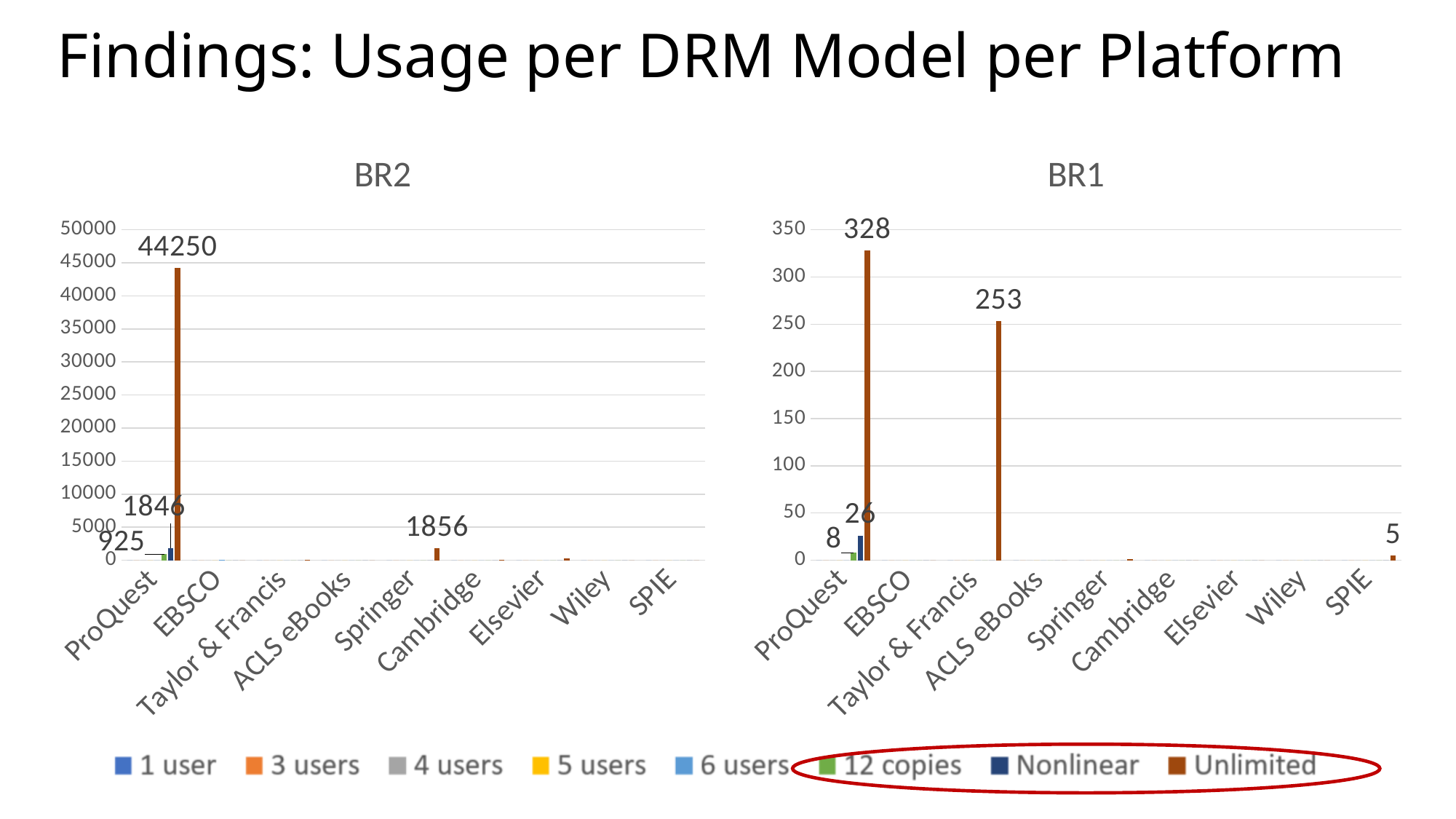
How many series does the legend list? 8 In the BR1 chart, which platform has the tallest bar? ProQuest In the BR1 chart, what is the value of the Nonlinear bar for ProQuest? 26 How many platforms are listed on the x axis of the BR2 chart? 9 In the BR1 chart, what is the value of the Unlimited bar for SPIE? 5